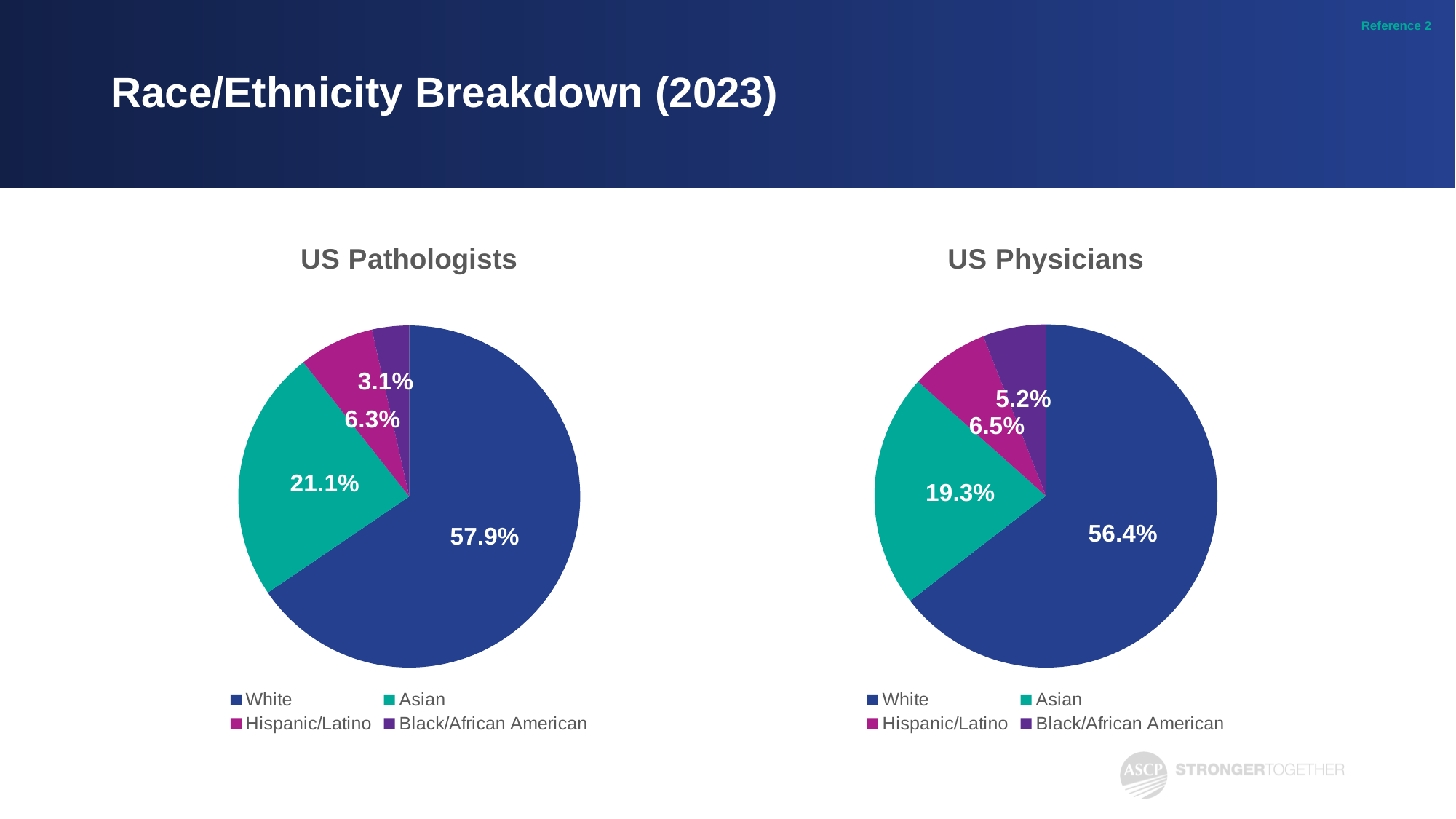
What kind of chart is the US Physicians chart? Pie chart In the US Physicians chart, what share of the pie is Asian? 19.3% In the US Pathologists chart, which category has the smallest slice? Black/African American How many categories does the US Pathologists chart show? 4 In the US Physicians chart, what is the value for Black/African American? 5.2% In the US Pathologists chart, what is the value for Hispanic/Latino? 6.3% Which is larger: the Asian share in the US Pathologists chart or the Asian share in the US Physicians chart? US Pathologists In the US Physicians chart, which category has the largest slice? White In the US Pathologists chart, which colour represents Asian? Teal In the US Pathologists chart, what share of the pie is White? 57.9% What is the difference between the White share in the US Pathologists chart and the White share in the US Physicians chart? 1.5% In the US Physicians chart, what is the difference between the Hispanic/Latino and Black/African American shares? 1.3%